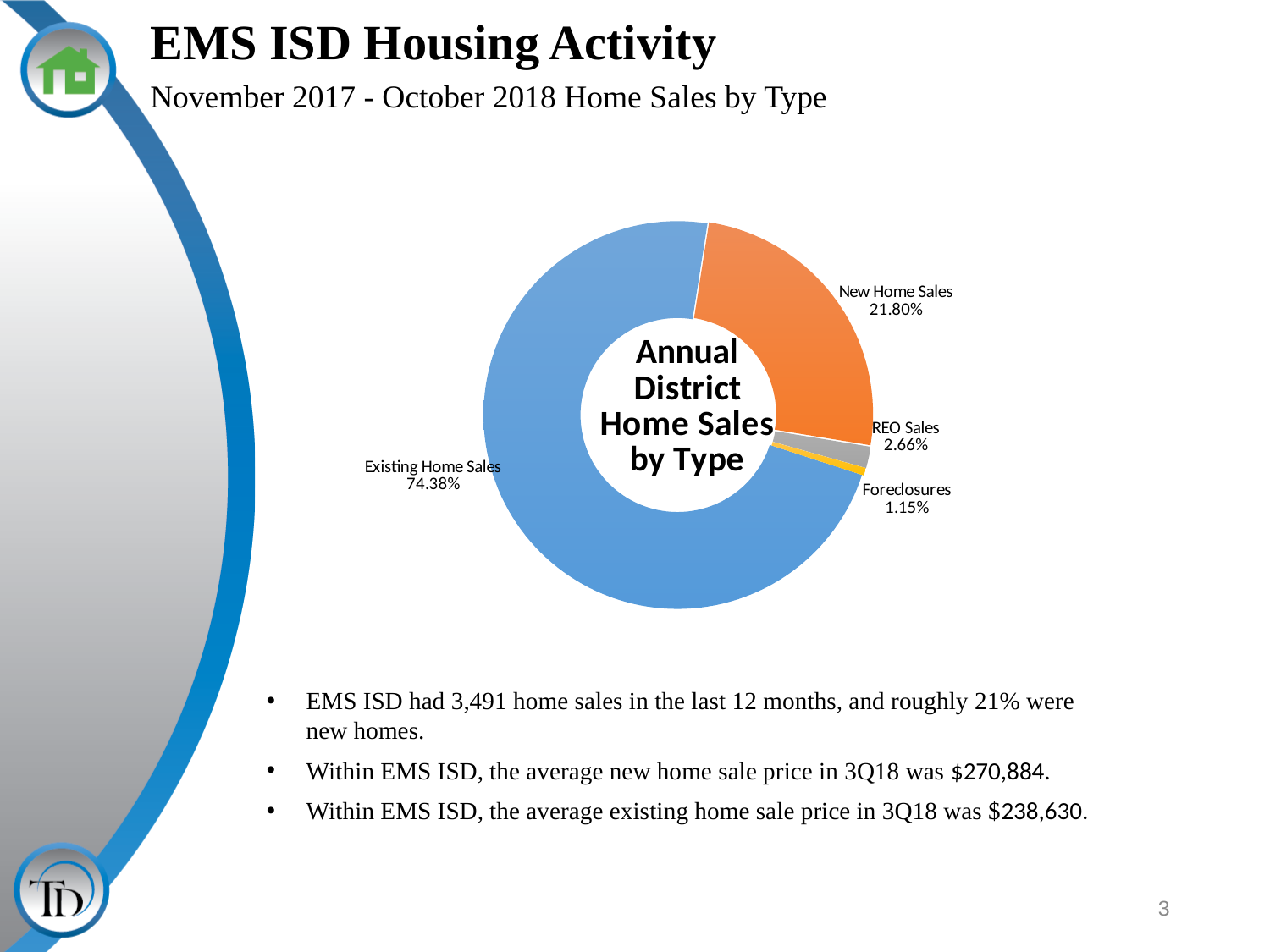
How many home sale types are shown in the chart? 4 What share of annual district home sales is REO Sales? 2.66% What is the difference in percentage points between Existing Home Sales and New Home Sales? 52.58 What share of annual district home sales is Existing Home Sales? 74.38% What share of annual district home sales is Foreclosures? 1.15% What is the title printed in the centre of the chart? Annual District Home Sales by Type What colour is the Existing Home Sales segment? Blue Which home sale type has the smallest share of the chart? Foreclosures Which home sale type has the largest share of the chart? Existing Home Sales What kind of chart is shown on the slide? Doughnut (pie) chart What share of annual district home sales is New Home Sales? 21.80% Which is larger, the share for REO Sales or the share for Foreclosures? REO Sales